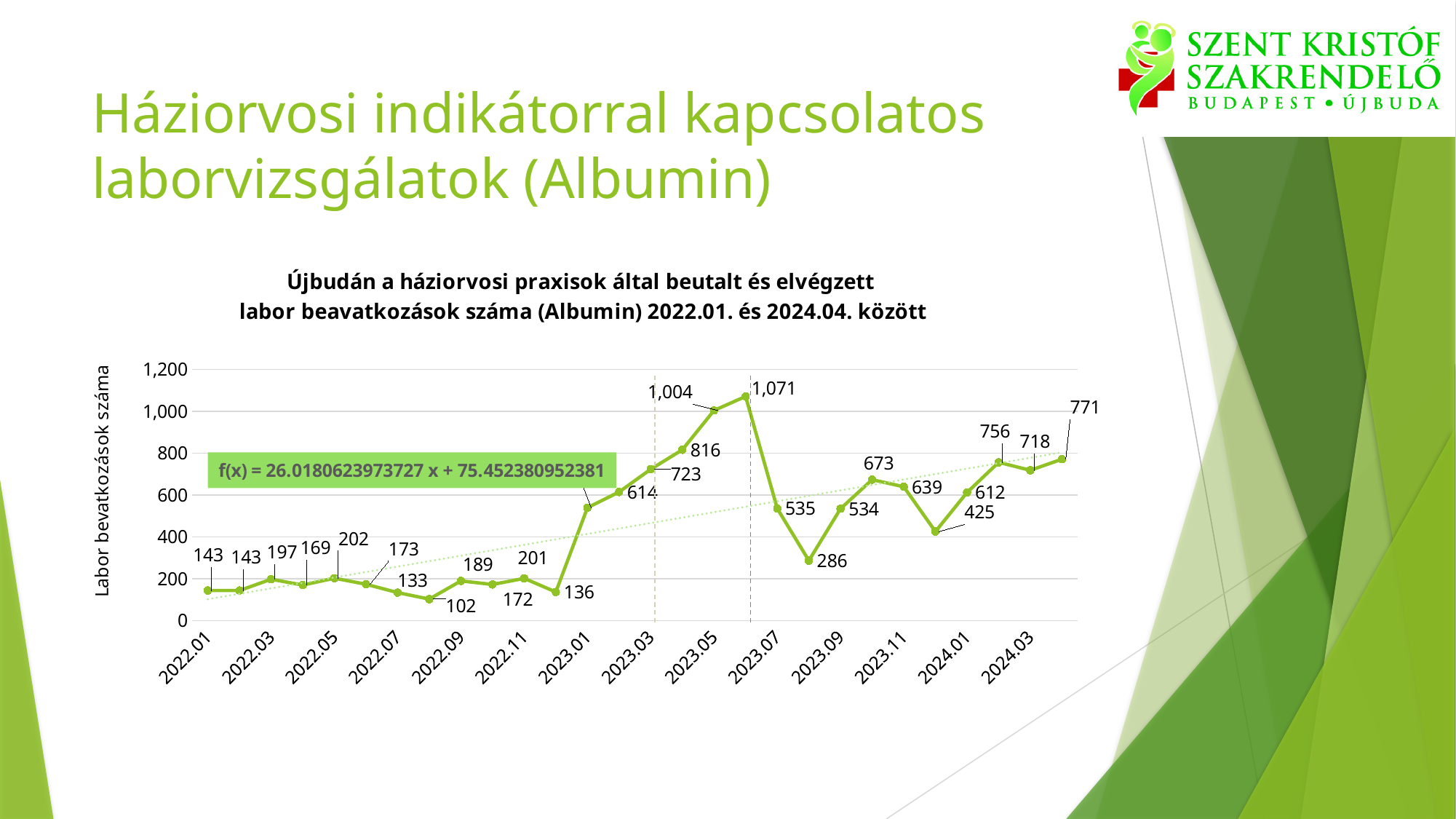
What is the label of the vertical axis? Labor beavatkozások száma Do the values generally rise or fall from 2022.01 to 2024.04? rise What is the lowest value plotted on the chart? 102 What is the value for 2023.09? 534 What is the highest value plotted on the chart? 1,071 What is the difference between the values for 2023.05 and 2023.03? 281 What kind of chart is shown on the slide? line chart What is the value for 2024.03? 718 What is the value for 2023.05? 1,004 Is the value for 2023.01 greater or less than 400? greater What is the value for 2022.01? 143 Which is larger, the value for 2023.07 or the value for 2023.11? 2023.11